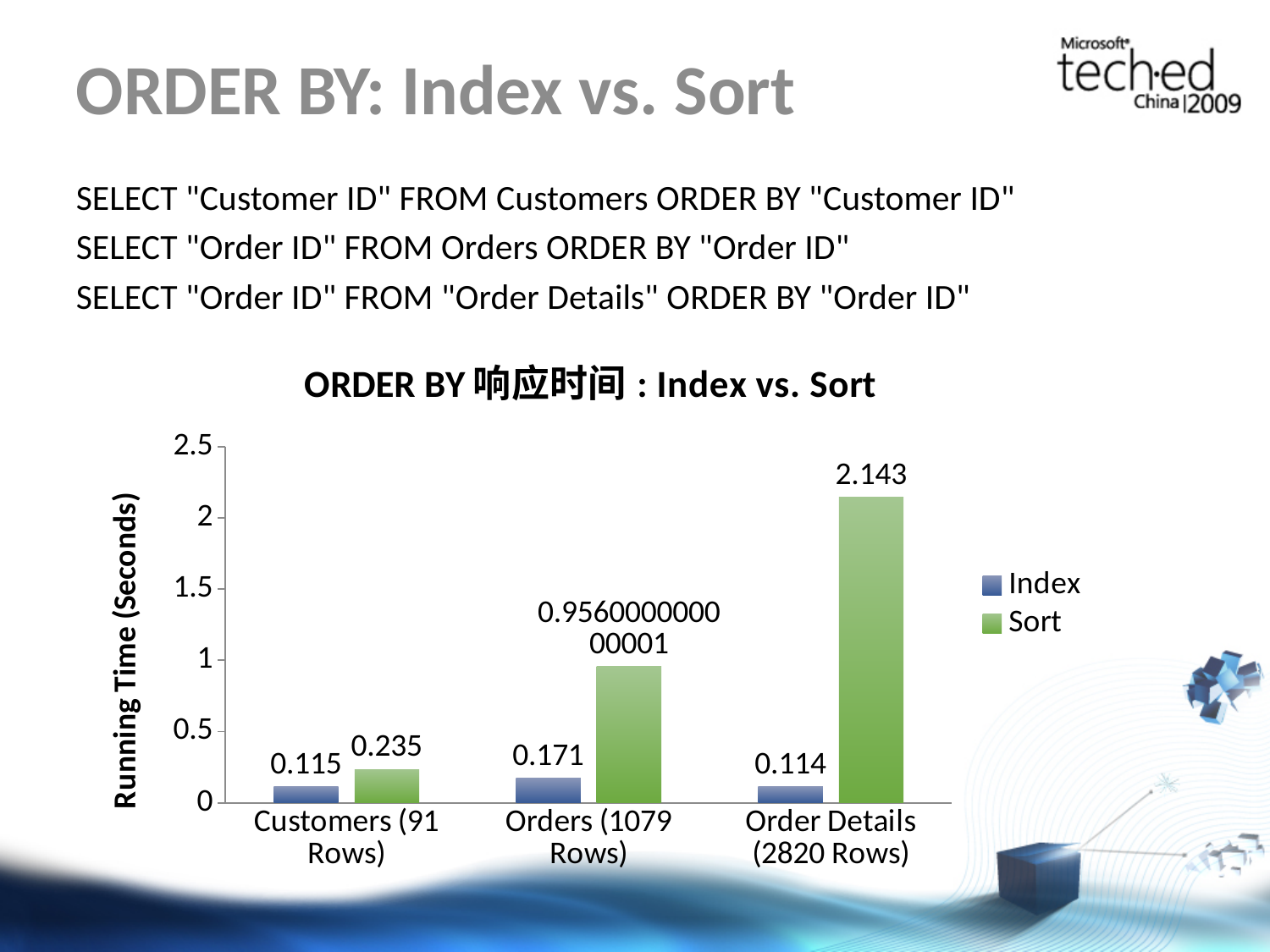
Is the Sort running time for Order Details (2820 Rows) greater or less than 2? greater What is the Sort running time for Customers (91 Rows)? 0.235 What is the difference between the Sort and Index running times for Order Details (2820 Rows)? 2.029 For Orders (1079 Rows), which is larger: the Index or the Sort running time? Sort Which category has the highest Sort running time? Order Details (2820 Rows) How many series does the legend list? 2 How many categories are shown on the x axis? 3 What is the Sort running time for Order Details (2820 Rows)? 2.143 What is the Index running time for Orders (1079 Rows)? 0.171 What kind of chart is shown on the slide? Bar chart Which category has the lowest Sort running time? Customers (91 Rows) What is the Index running time for Customers (91 Rows)? 0.115